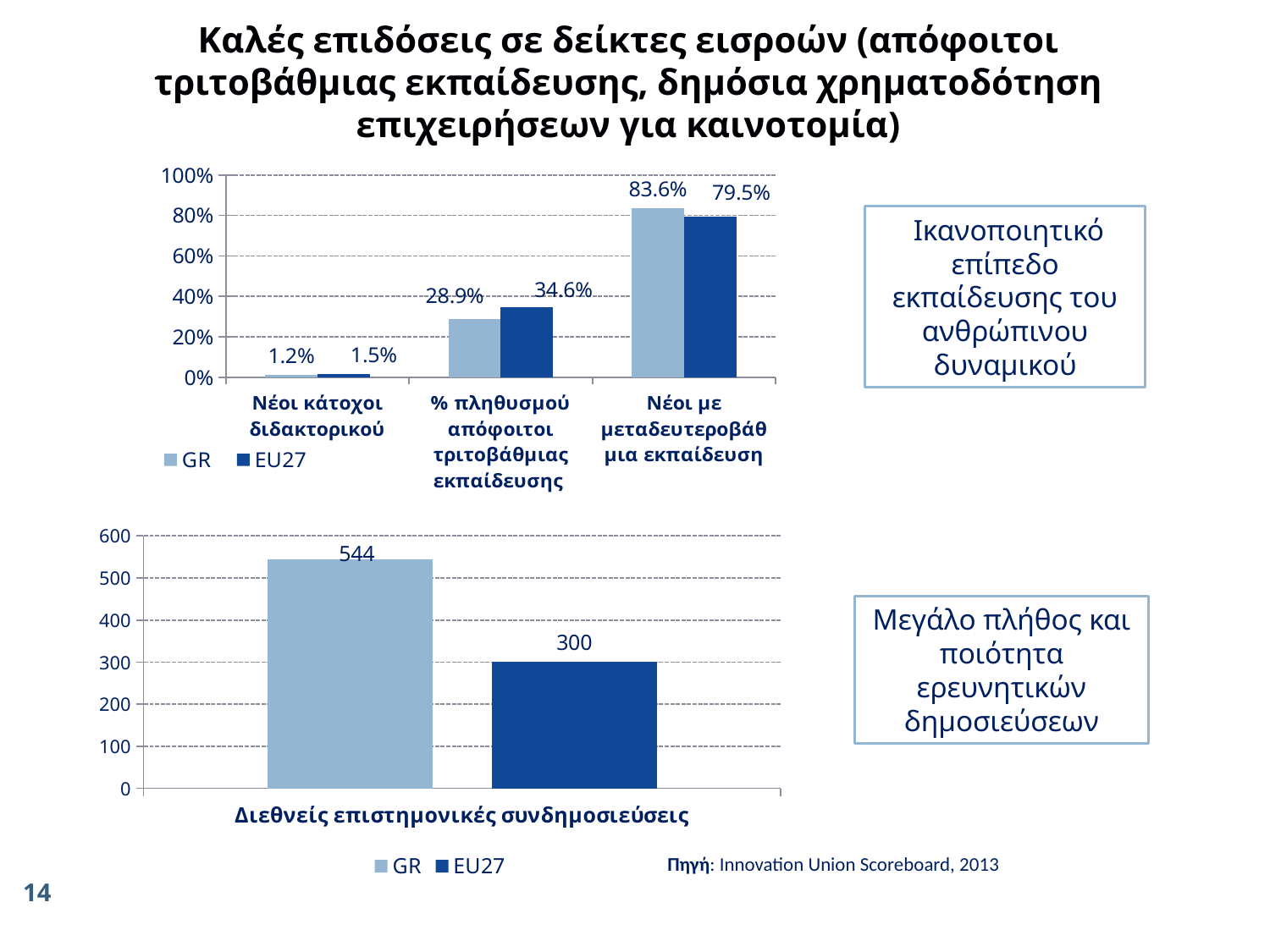
How many categories are shown on the x axis of the top chart? 3 In the top chart, what is the difference between the EU27 and GR values for % πληθυσμού απόφοιτοι τριτοβάθμιας εκπαίδευσης? 5.7% In the top chart, what is the EU27 value for Νέοι κάτοχοι διδακτορικού? 1.5% In the top chart, what is the EU27 value for % πληθυσμού απόφοιτοι τριτοβάθμιας εκπαίδευσης? 34.6% In the top chart, which is larger for Νέοι με μεταδευτεροβάθμια εκπαίδευση, GR or EU27? GR What kind of chart is the bottom chart? Bar chart In the top chart, which category has the highest GR value? Νέοι με μεταδευτεροβάθμια εκπαίδευση How many series does the legend of the bottom chart list? 2 In the top chart, what is the GR value for Νέοι με μεταδευτεροβάθμια εκπαίδευση? 83.6% In the bottom chart, what is the difference between the GR and EU27 values? 244 In the bottom chart, what is the GR value for Διεθνείς επιστημονικές συνδημοσιεύσεις? 544 In the top chart, which category has the lowest EU27 value? Νέοι κάτοχοι διδακτορικού